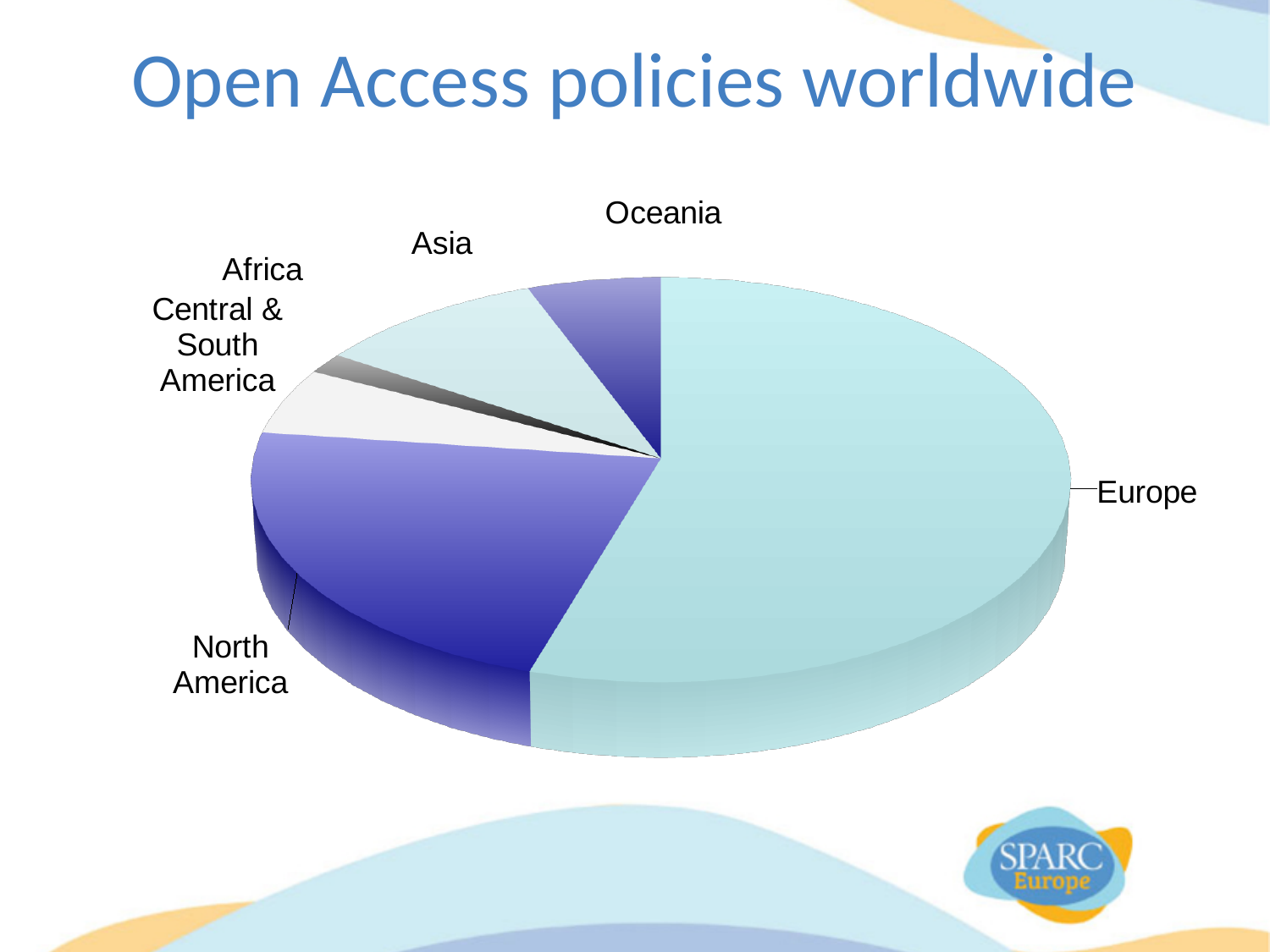
Which slice is larger, North America or Oceania? North America Which region has the second-largest slice of the pie chart? North America Which slice is larger, Asia or Oceania? Asia Which slice is larger, Asia or Africa? Asia What is the title of the chart on the slide? Open Access policies worldwide How many regions (slices) does the pie chart show? 6 Which region has the smallest slice of the pie chart? Africa Which region's slice is labelled on the right-hand side of the pie chart? Europe Which region has the largest slice of the pie chart? Europe What kind of chart is shown on the slide? pie chart